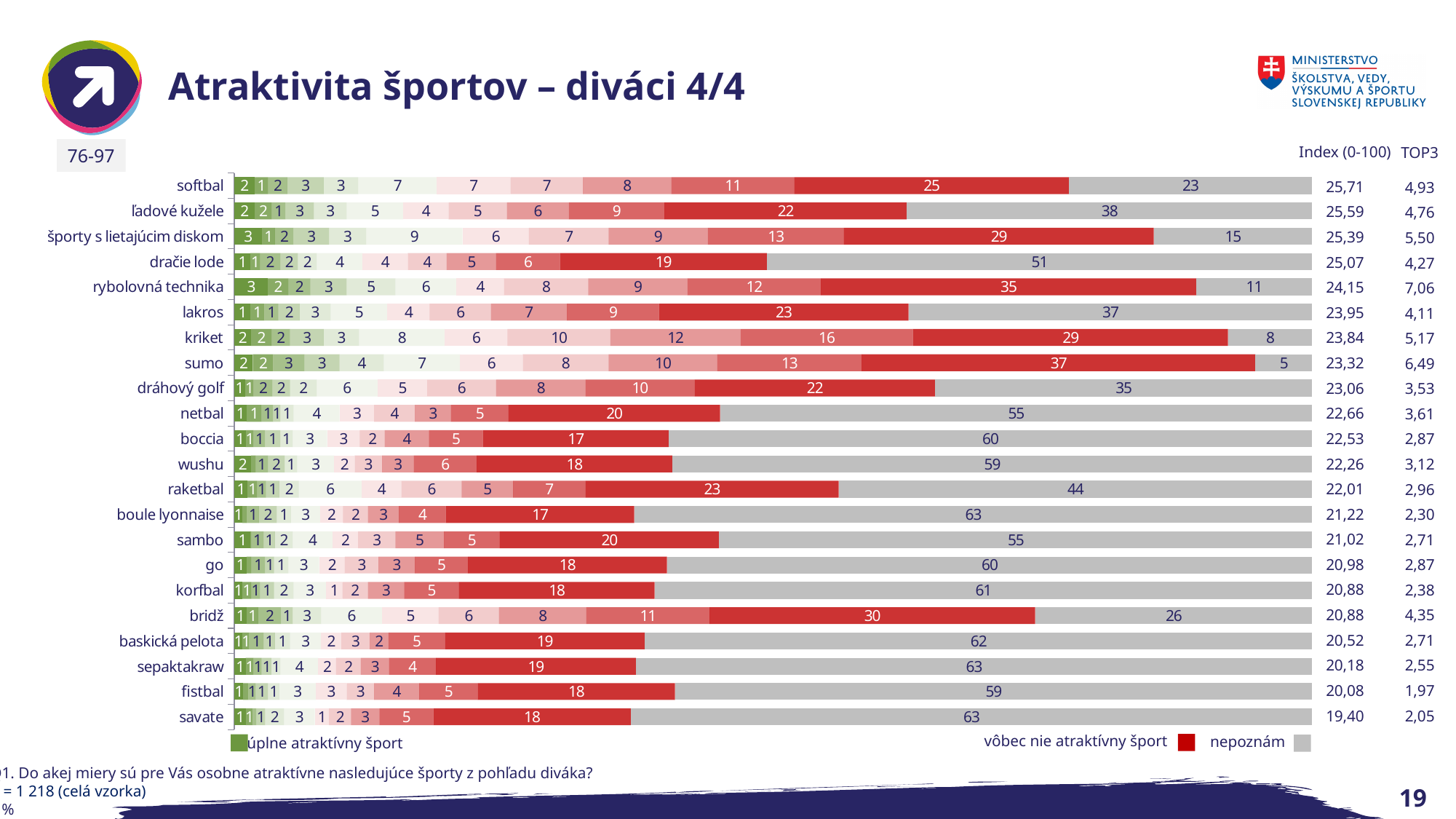
What is the Index (0-100) value for rybolovná technika? 24,15 What is the 'vôbec nie atraktívny šport' (dark red) value for sumo? 37 What is the difference between the 'nepoznám' values for ľadové kužele and softbal? 15 What kind of chart is shown on the slide? stacked bar chart How many sports are listed in the chart? 22 Which sport has the highest TOP3 value? rybolovná technika Which sport has the lowest Index (0-100) value? savate What is the 'nepoznám' (grey) value for dračie lode? 51 Which sport has the highest 'vôbec nie atraktívny šport' (dark red) value? sumo Which has a larger 'nepoznám' value, netbal or raketbal? netbal What does the green legend entry at the bottom left of the chart say? úplne atraktívny šport Which sport has the lowest 'nepoznám' (grey) value? sumo